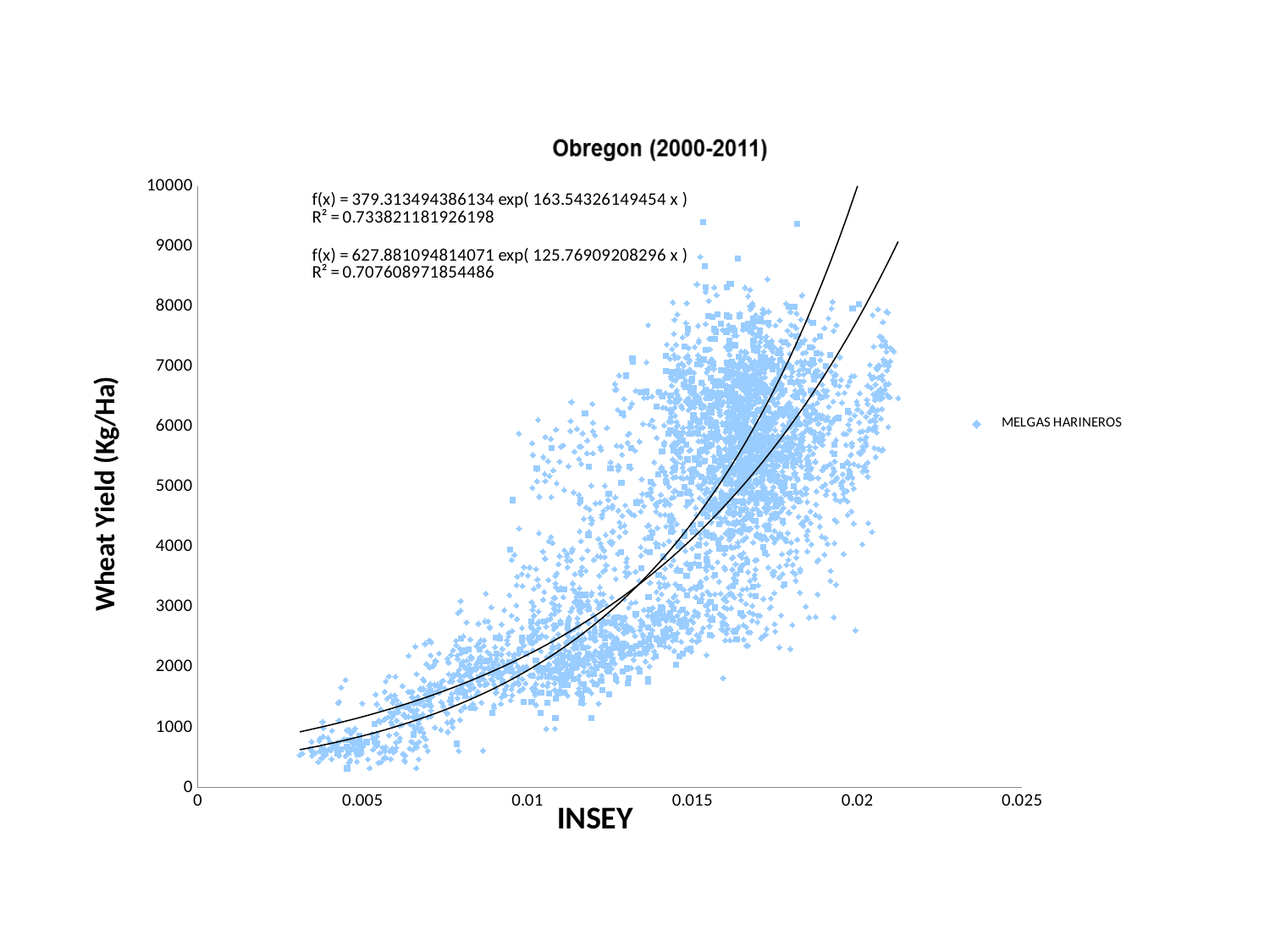
What kind of chart is shown on the slide? scatter plot What is the title of the chart? Obregon (2000-2011) What is the name of the series shown in the legend? MELGAS HARINEROS How many fitted trend curves are drawn on the chart? 2 Which fitted curve has the higher R² value, the one with coefficient 379.313494386134 or the one with coefficient 627.881094814071? 379.313494386134 Does wheat yield generally rise or fall as INSEY increases along the x axis? rise What is the maximum value shown on the y axis? 10000 What is the maximum value shown on the x axis? 0.025 How many series does the legend list? 1 What is the R² value of the first fitted curve, f(x) = 379.313494386134 exp( 163.54326149454 x )? 0.733821181926198 What is the R² value of the second fitted curve, f(x) = 627.881094814071 exp( 125.76909208296 x )? 0.707608971854486